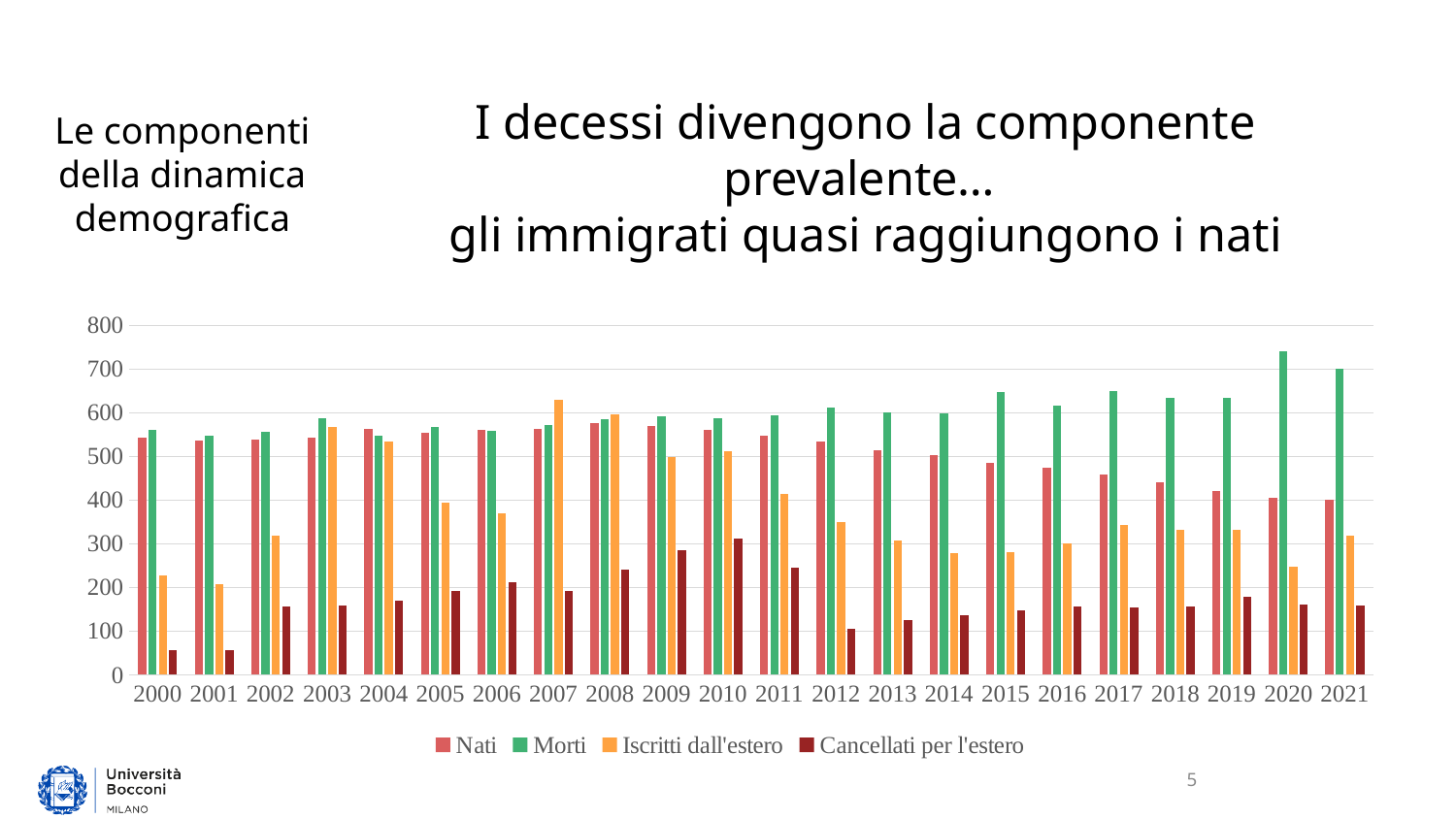
In which year is the value for Iscritti dall'estero highest? 2007 Is the value for Morti in 2020 greater or less than 700? greater In 2007, which is larger: Nati or Iscritti dall'estero? Iscritti dall'estero How many series does the legend list? 4 Is the value for Nati in 2021 greater or less than 500? less What kind of chart is shown on the slide? bar chart How many years are shown on the x axis? 22 In 2021, which is larger: Nati or Morti? Morti In which year is the value for Morti highest? 2020 Do the values for Nati rise or fall from 2000 to 2021? fall Is the value for Cancellati per l'estero in 2000 greater or less than 100? less Which series is shown in dark red in the legend? Cancellati per l'estero